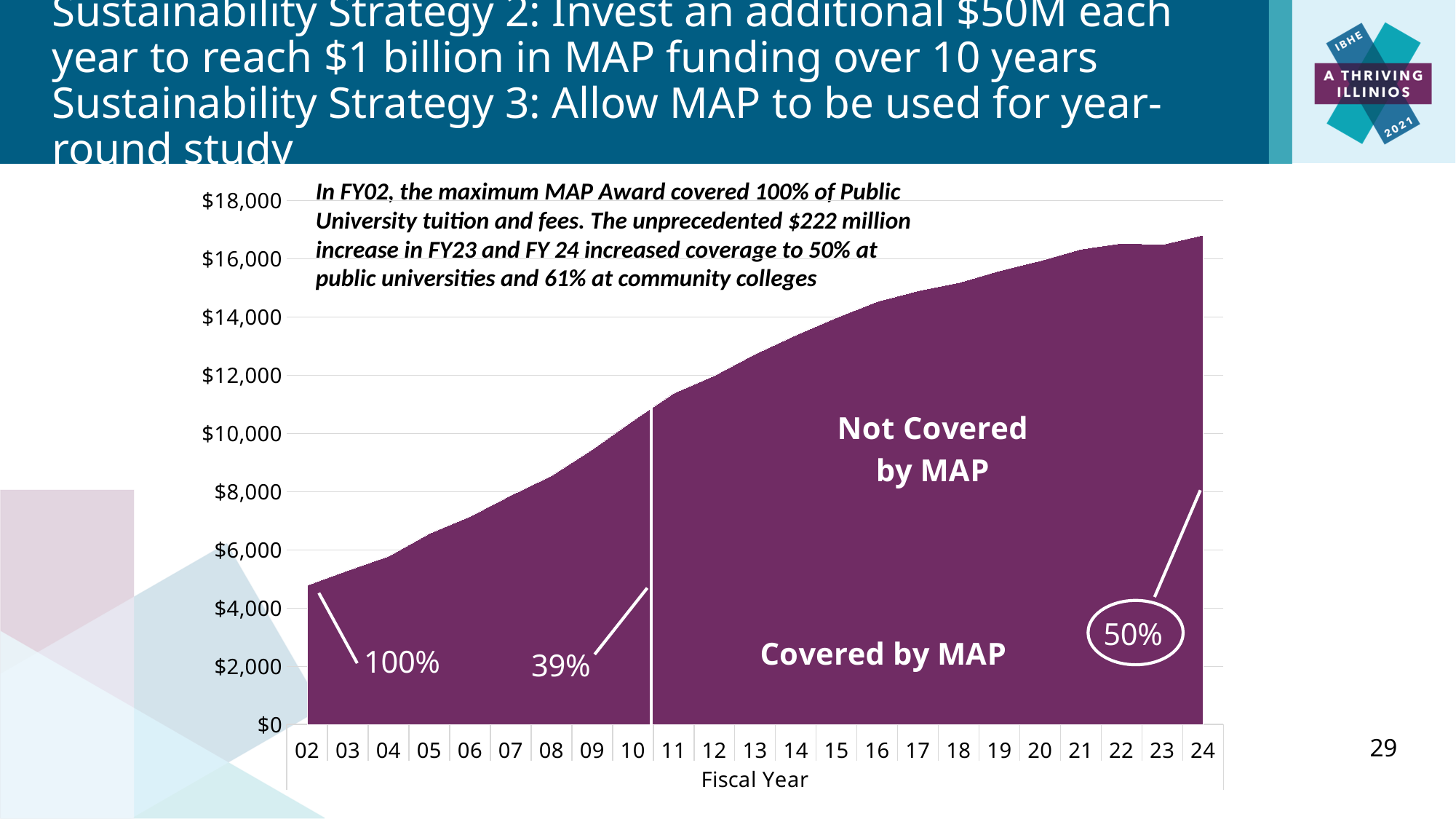
How many fiscal years are shown along the x axis of the chart? 23 What kind of chart is shown on the slide? Area chart Which fiscal year has the highest value in the chart? 24 Is the value for fiscal year 18 greater or less than $14,000? greater According to the annotation on the chart, what percentage of tuition and fees did the maximum MAP award cover in FY02? 100% Which fiscal year has the lowest value in the chart? 02 According to the circled annotation on the chart, what percentage is covered by MAP in FY24? 50% Do the values in the chart rise or fall from FY02 to FY24? Rise Is the value for fiscal year 24 greater or less than $16,000? greater Is the value for fiscal year 10 greater or less than $10,000? greater What is the title of the x axis of the chart? Fiscal Year